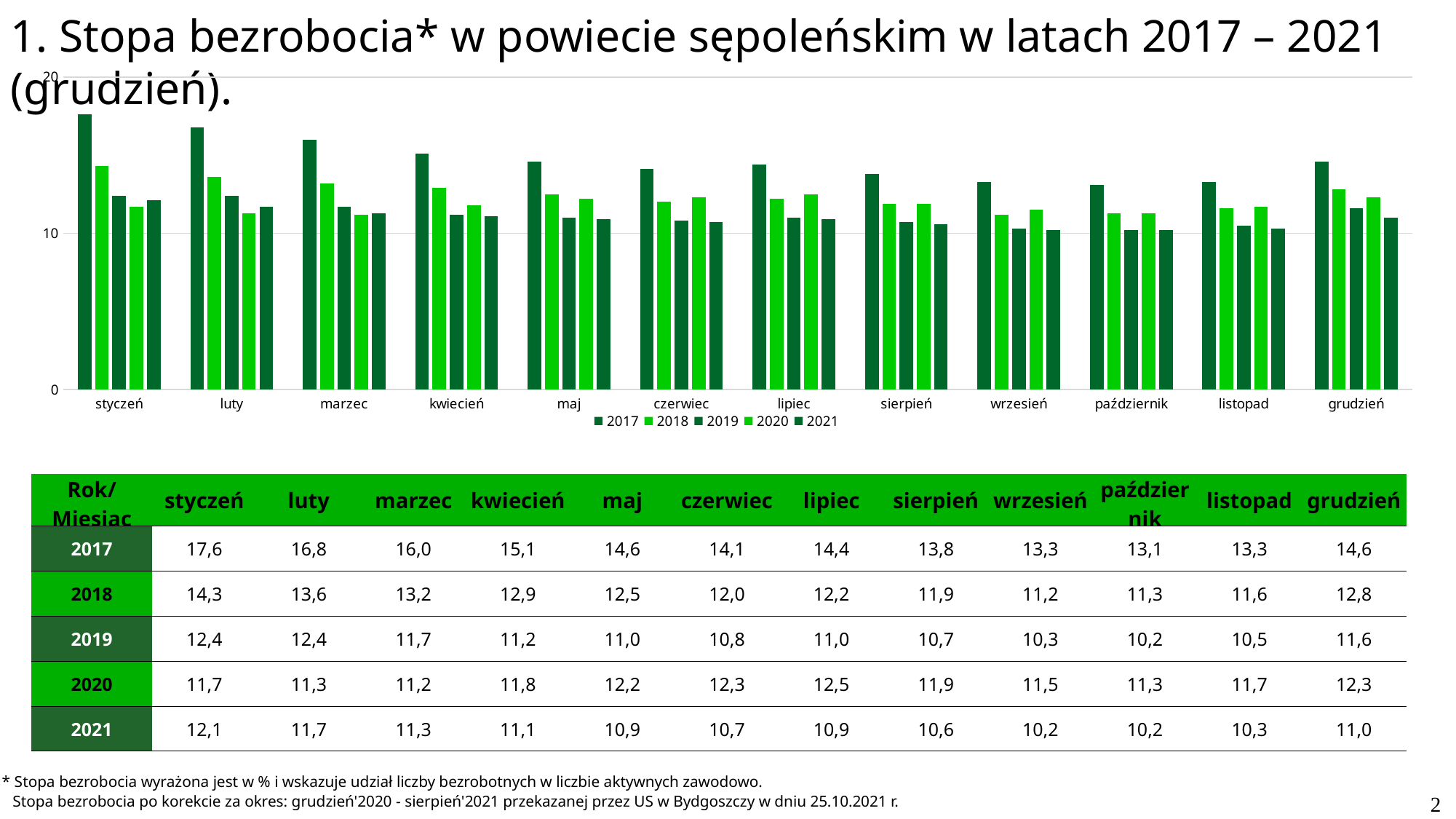
Which month has the lowest value for the 2018 series? wrzesień Does the 2017 series rise or fall from styczeń to kwiecień? fall What kind of chart is shown on the slide? bar chart In maj, which series has the larger value: 2019 or 2020? 2020 What is the difference between the 2017 and 2021 values in styczeń? 5,5 Which month has the highest value for the 2017 series? styczeń Which month has the highest value for the 2020 series? lipiec How many series does the chart legend list? 5 Is the value for 2017 in styczeń greater or less than 20? less What is the unemployment rate for 2020 in lipiec? 12,5 How many month categories are shown on the x axis of the chart? 12 What is the unemployment rate for 2017 in styczeń? 17,6